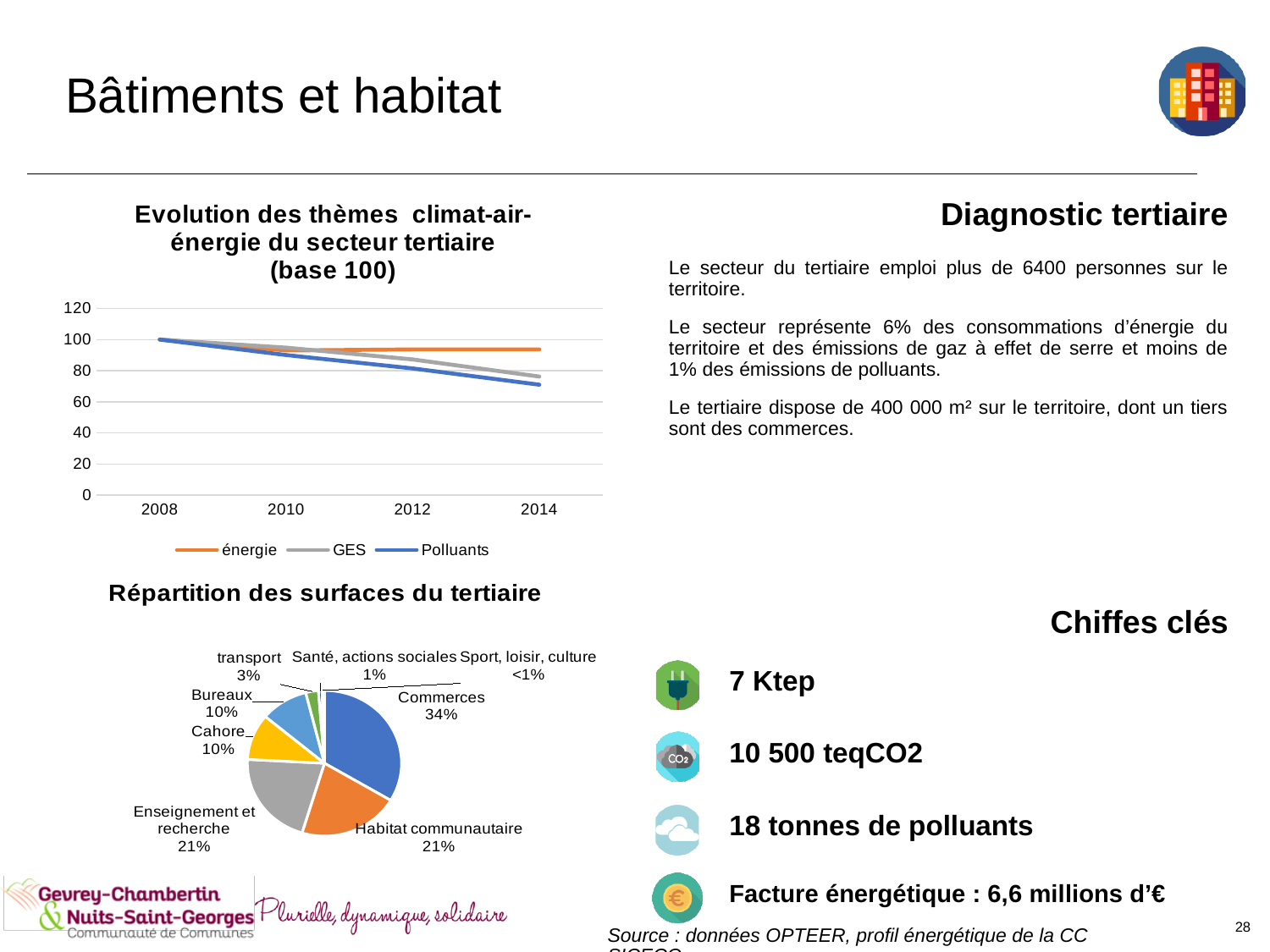
In the chart 'Evolution des thèmes climat-air-énergie du secteur tertiaire (base 100)', does the Polluants series rise or fall from 2008 to 2014? Fall In the pie chart 'Répartition des surfaces du tertiaire', how many categories are shown? 8 In the pie chart 'Répartition des surfaces du tertiaire', what is the share for Habitat communautaire? 21% In the pie chart 'Répartition des surfaces du tertiaire', which category has the largest share? Commerces What kind of chart is 'Répartition des surfaces du tertiaire'? Pie chart In the pie chart 'Répartition des surfaces du tertiaire', which is larger, Cahore or transport? Cahore In the chart 'Evolution des thèmes climat-air-énergie du secteur tertiaire (base 100)', is the value for Polluants in 2014 greater or less than 80? less What kind of chart is 'Evolution des thèmes climat-air-énergie du secteur tertiaire (base 100)'? Line chart In the chart 'Evolution des thèmes climat-air-énergie du secteur tertiaire (base 100)', how many series does the legend list? 3 In the chart 'Evolution des thèmes climat-air-énergie du secteur tertiaire (base 100)', which series has the highest value in 2014? énergie In the pie chart 'Répartition des surfaces du tertiaire', what is the difference in percentage points between Commerces and Bureaux? 24 percentage points In the pie chart 'Répartition des surfaces du tertiaire', what share of the surface is Commerces? 34%